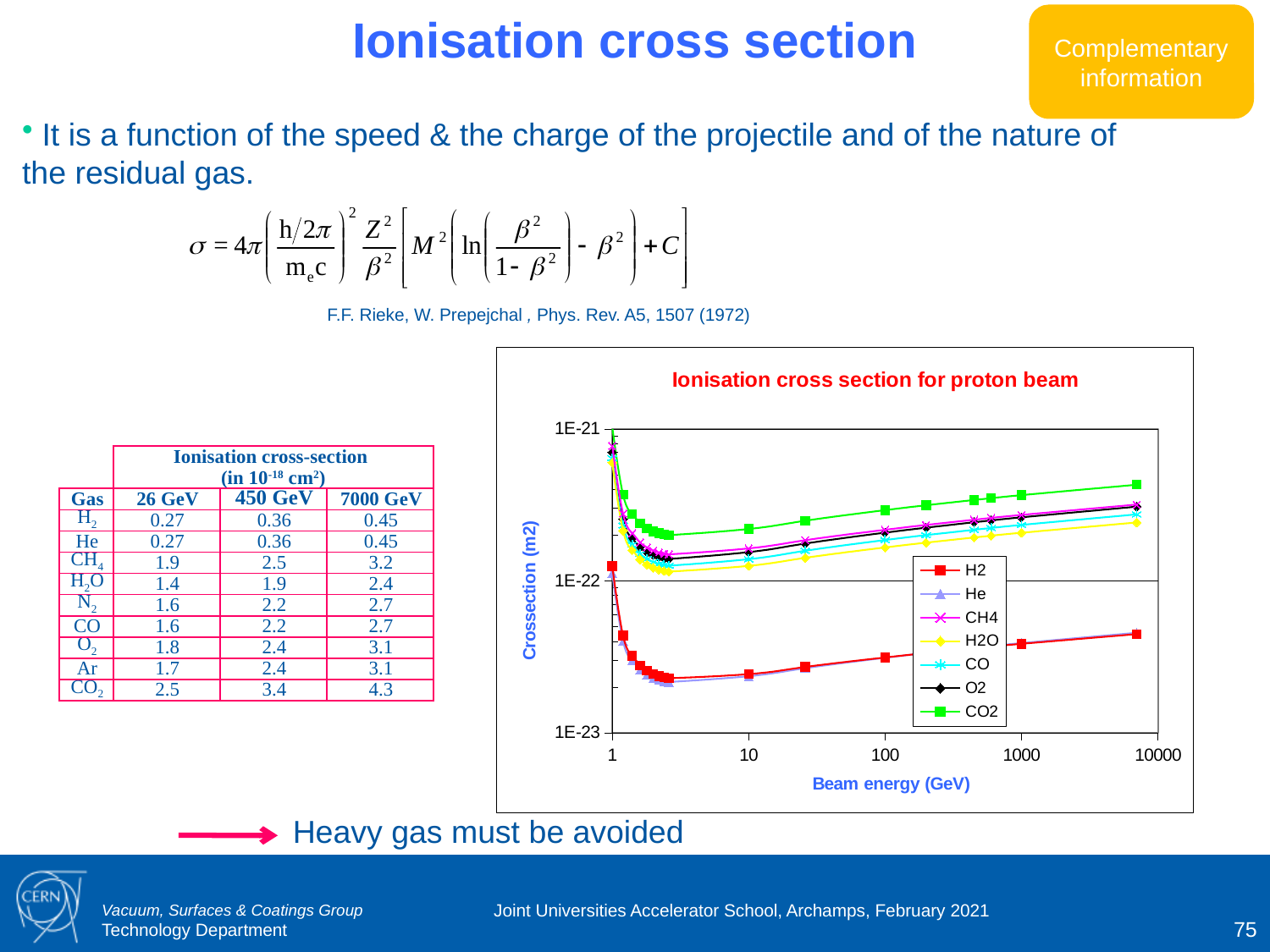
Is the cross section for H2O at 100 GeV greater or less than 1E-22? greater At 100 GeV, which has the larger cross section, CH4 or H2? CH4 Between 1 GeV and 10 GeV, does the cross section for H2 rise or fall? fall What kind of chart is shown on the slide? line chart At 1000 GeV, which has the larger cross section, CO2 or H2O? CO2 Is the cross section for CO2 at 1000 GeV greater or less than 1E-22? greater What is the label of the x axis of the chart? Beam energy (GeV) How many series does the chart's legend list? 7 Between 10 GeV and 10000 GeV, does the cross section for CO2 rise or fall? rise What is the title of the chart on the slide? Ionisation cross section for proton beam Is the cross section for H2 at 10 GeV greater or less than 1E-22? less